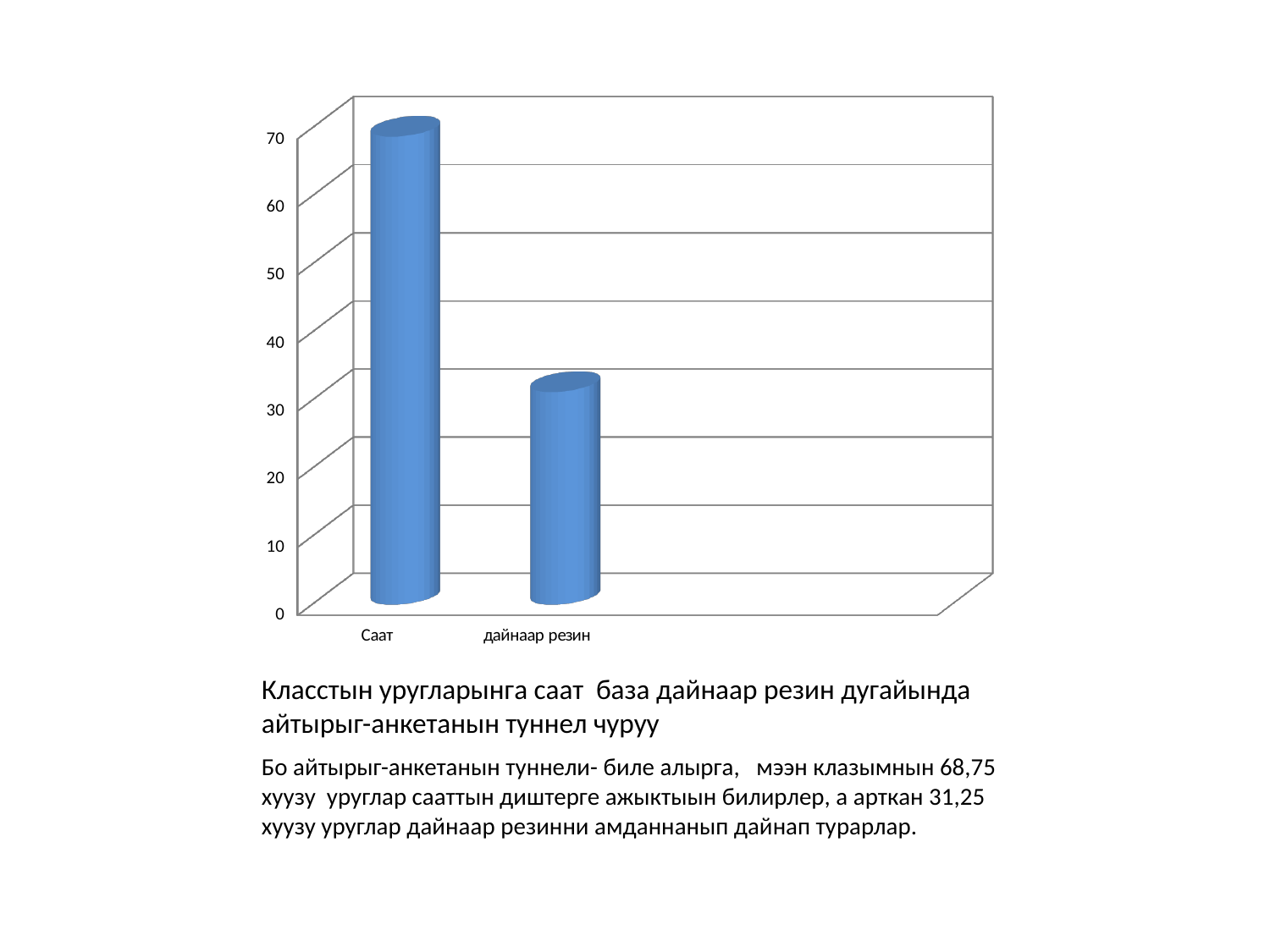
Which category has the lowest bar? дайнаар резин Which is larger, the value for Саат or the value for дайнаар резин? Саат What is the highest value labelled on the vertical axis? 70 Do the bar values rise or fall from left to right along the x axis? fall Is the value for Саат greater or less than 60? greater How many categories are plotted on the chart? 2 What colour are the bars on the chart? blue Which category has the highest bar? Саат Is the value for дайнаар резин greater or less than 20? greater What kind of chart is shown on the slide? bar chart Is the value for дайнаар резин greater or less than 40? less